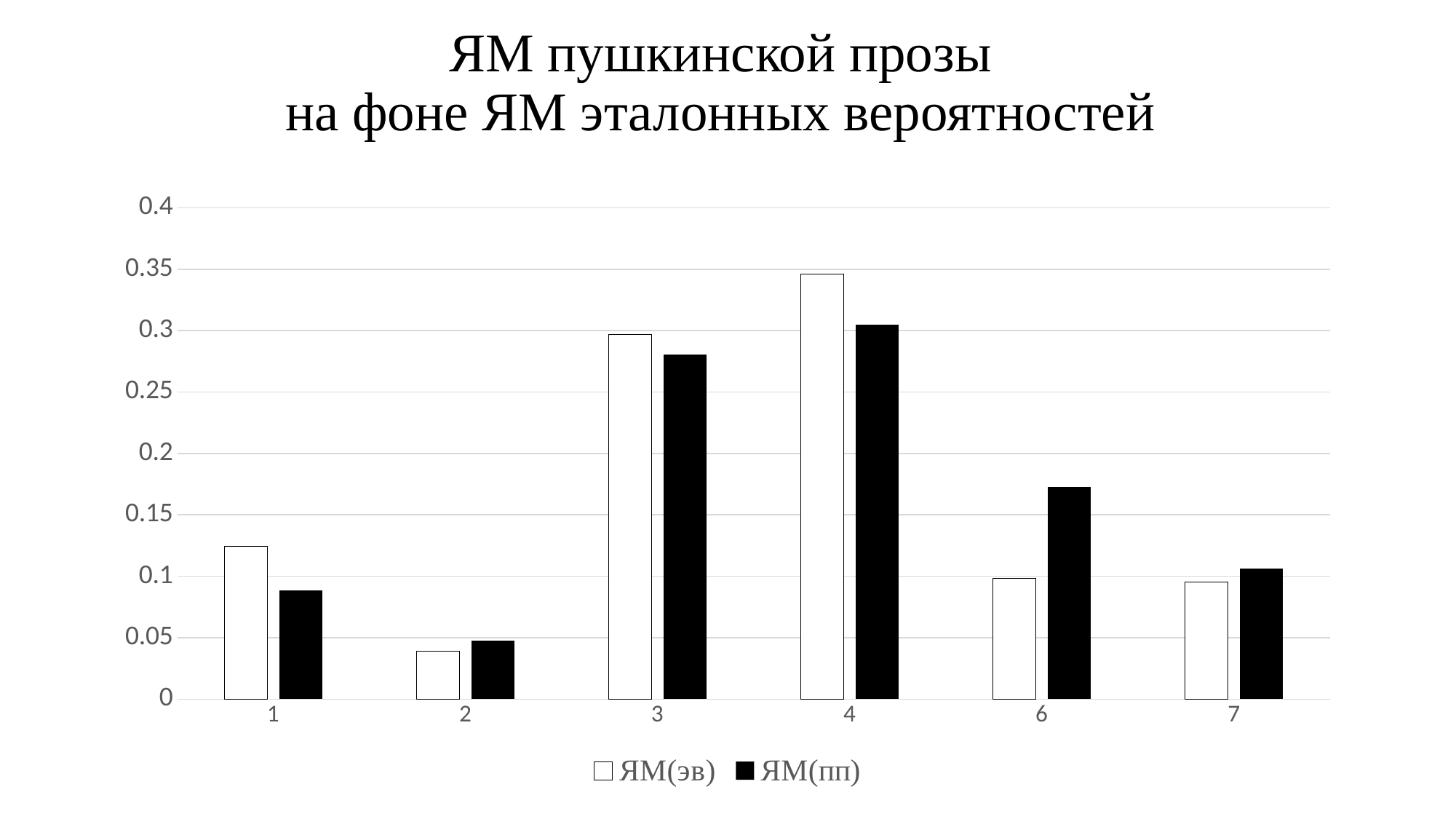
For category 1, which series has the larger value, ЯМ(эв) or ЯМ(пп)? ЯМ(эв) Which category has the highest value for the ЯМ(эв) series? 4 Is the ЯМ(пп) value for category 6 greater or less than 0.15? greater How many categories are shown on the x axis? 6 Which category has the lowest value for the ЯМ(пп) series? 2 Which series is drawn with black bars? ЯМ(пп) How many series does the legend list? 2 Is the ЯМ(эв) value for category 4 greater or less than 0.3? greater Is the ЯМ(эв) value for category 2 greater or less than 0.05? less For category 6, which series has the larger value, ЯМ(эв) or ЯМ(пп)? ЯМ(пп) What kind of chart is shown on the slide? bar chart Which category has the highest value for the ЯМ(пп) series? 4